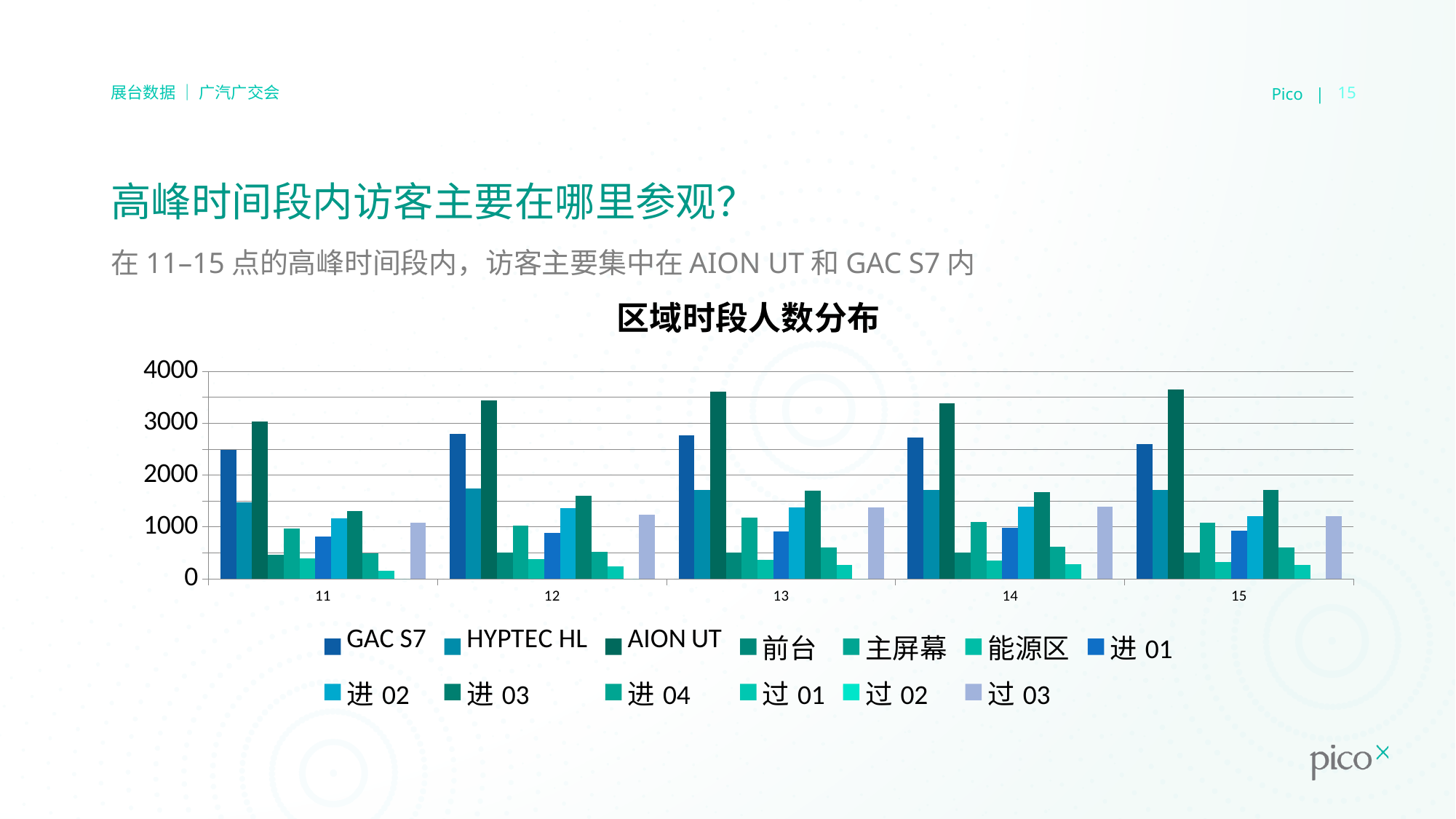
What is the title of the chart? 区域时段人数分布 Is the value for GAC S7 at hour 11 greater or less than 2000? greater Is the value for AION UT at hour 13 greater or less than 3000? greater At which hour is the AION UT value lowest? 11 Which series has the highest value at hour 13? AION UT What kind of chart is shown on the slide? bar chart How many time-slot categories are shown on the x axis of the chart? 5 Is the value for 前台 at hour 12 greater or less than 2000? less At hour 12, which is larger: the value for HYPTEC HL or the value for 前台? HYPTEC HL Which series has the lowest value at hour 11? 过 02 How many series does the chart's legend list? 13 At hour 14, which is larger: the value for GAC S7 or the value for AION UT? AION UT